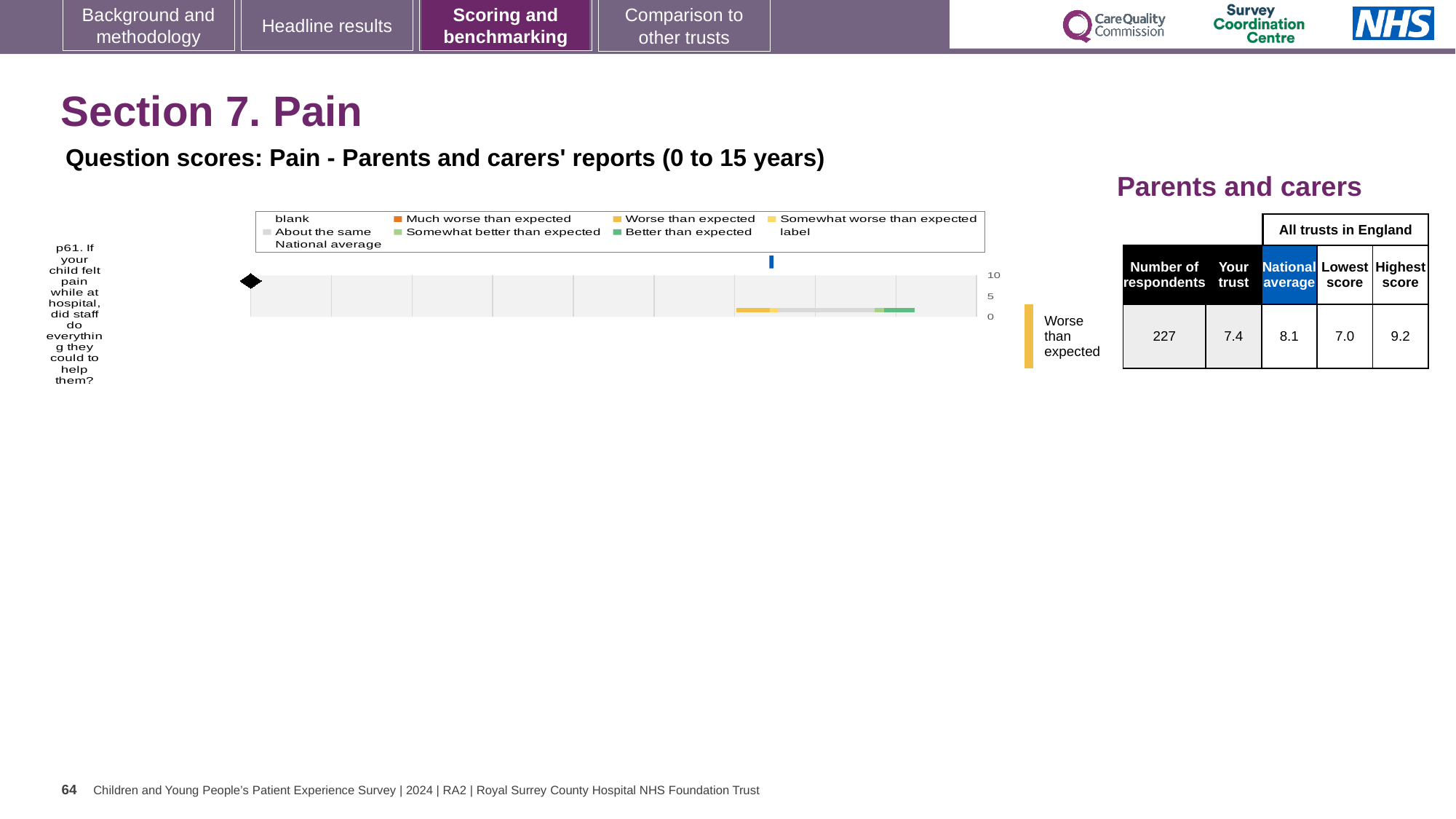
What is the national average score for question p61? 8.1 How many respondents answered question p61? 227 What is the difference between the highest and lowest scores among all trusts for question p61? 2.2 What rating is shown next to the chart for question p61? Worse than expected Which question number is plotted in the chart? p61 How many questions (categories) are plotted in the chart? 1 What is the 'Your trust' score for question p61? 7.4 What is the difference between the national average and the trust's score for question p61? 0.7 Which is larger for question p61, the trust's score or the national average? national average What is the lowest score among all trusts in England for question p61? 7.0 What is the highest score among all trusts in England for question p61? 9.2 What kind of chart is shown on the slide? bar chart